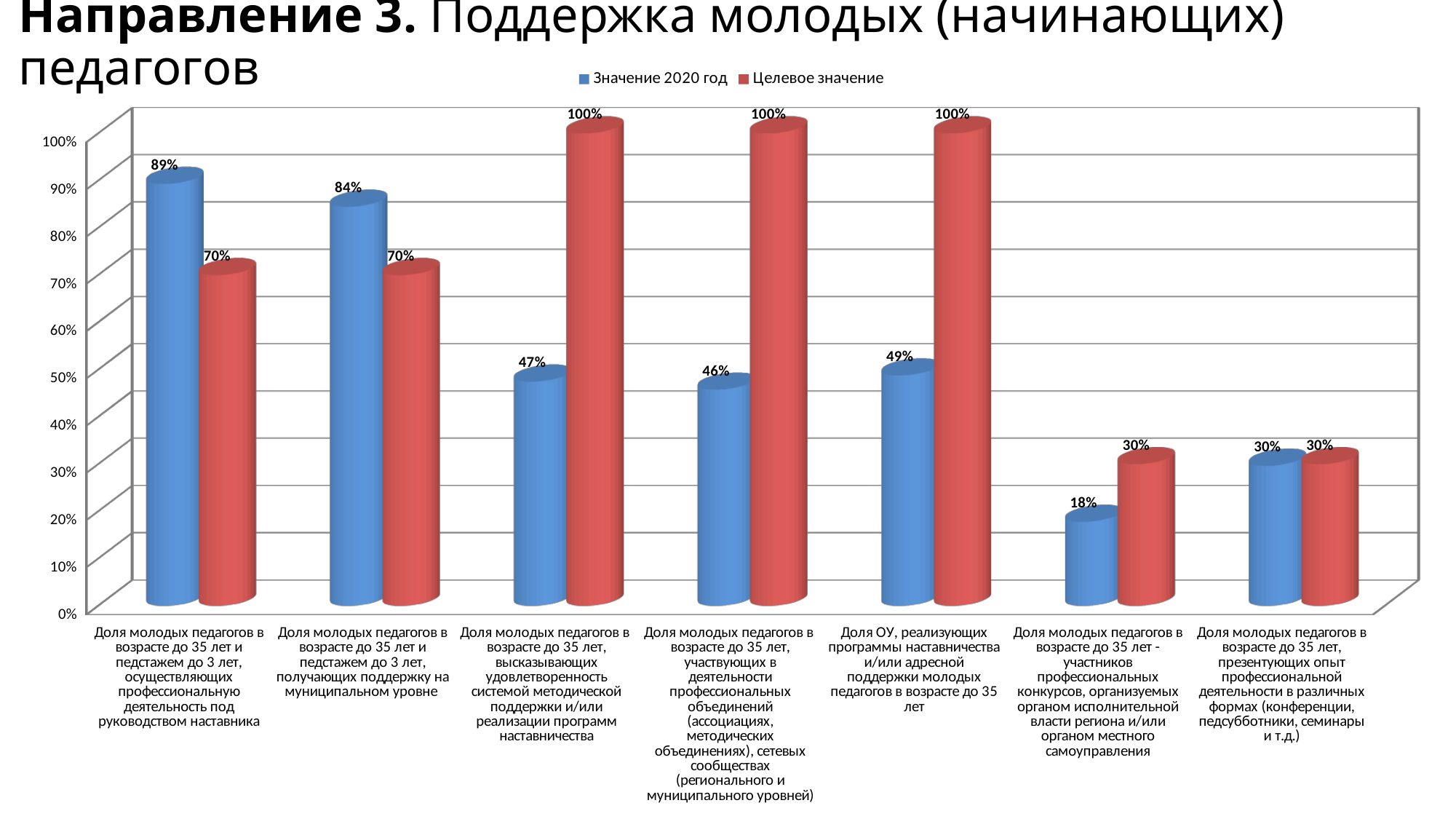
Which colour represents the 'Целевое значение' series in the chart? Red What is the 'Значение 2020 год' value for 'Доля молодых педагогов в возрасте до 35 лет, участвующих в деятельности профессиональных объединений (ассоциациях, методических объединениях), сетевых сообществах (регионального и муниципального уровней)'? 46% How many series does the legend list? 2 What is the 'Значение 2020 год' value for 'Доля ОУ, реализующих программы наставничества и/или адресной поддержки молодых педагогов в возрасте до 35 лет'? 49% What is the 'Значение 2020 год' value for 'Доля молодых педагогов в возрасте до 35 лет и педстажем до 3 лет, осуществляющих профессиональную деятельность под руководством наставника'? 89% Which category has the highest 'Значение 2020 год' value? Доля молодых педагогов в возрасте до 35 лет и педстажем до 3 лет, осуществляющих профессиональную деятельность под руководством наставника How many categories are shown on the x axis of the chart? 7 What is the 'Целевое значение' for 'Доля молодых педагогов в возрасте до 35 лет и педстажем до 3 лет, получающих поддержку на муниципальном уровне'? 70% For 'Доля молодых педагогов в возрасте до 35 лет и педстажем до 3 лет, получающих поддержку на муниципальном уровне', which is larger: the 'Значение 2020 год' or the 'Целевое значение'? Значение 2020 год What kind of chart is shown on the slide? Bar chart What is the difference between the 'Целевое значение' and the 'Значение 2020 год' for 'Доля молодых педагогов в возрасте до 35 лет, высказывающих удовлетворенность системой методической поддержки и/или реализации программ наставничества'? 53% Which category has the lowest 'Значение 2020 год' value? Доля молодых педагогов в возрасте до 35 лет - участников профессиональных конкурсов, организуемых органом исполнительной власти региона и/или органом местного самоуправления